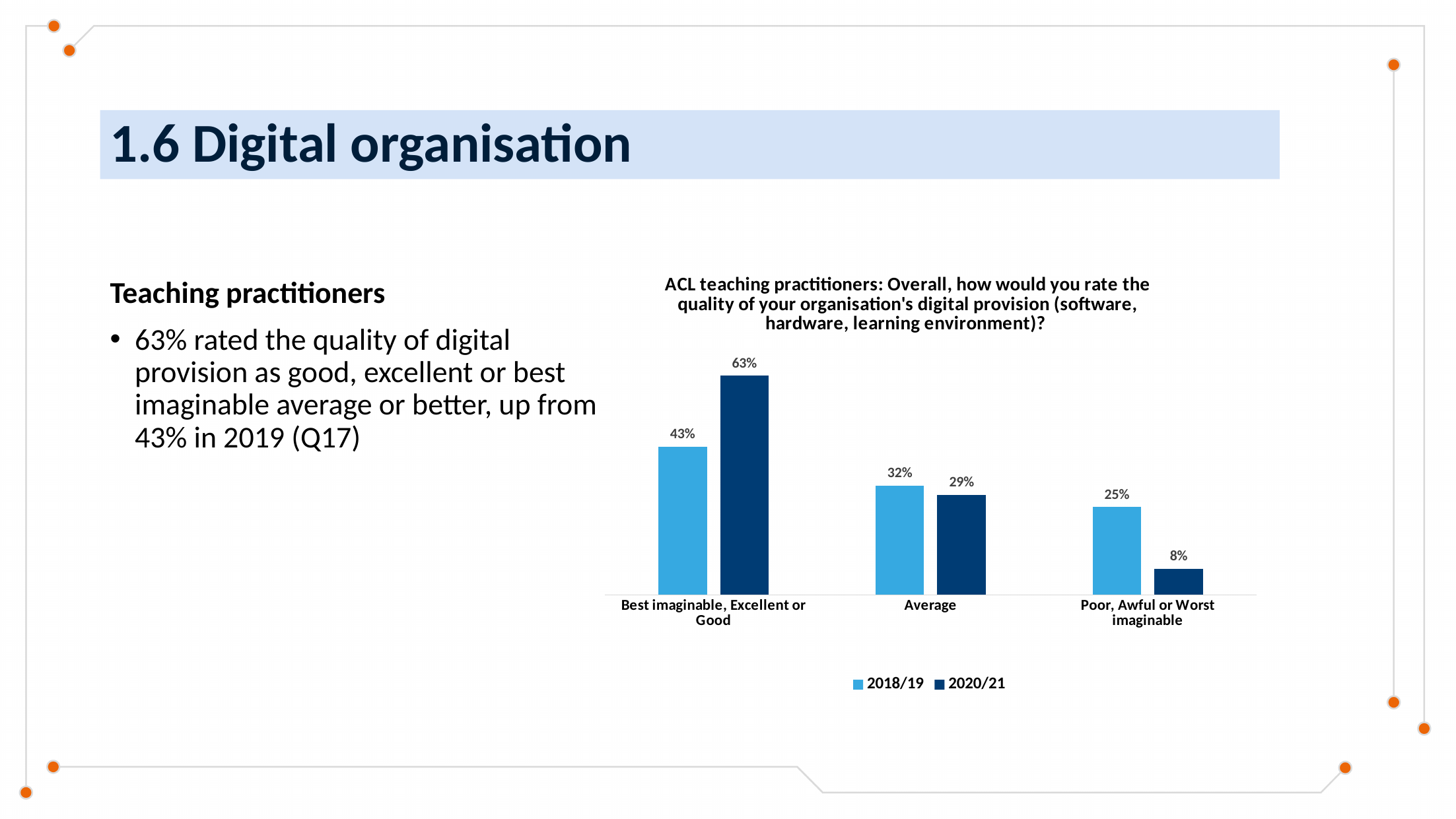
What percentage of ACL teaching practitioners rated digital provision as Best imaginable, Excellent or Good in 2018/19? 43% By how many percentage points did the Best imaginable, Excellent or Good rating change from 2018/19 to 2020/21? 20 percentage points What is the 2020/21 value for the Poor, Awful or Worst imaginable category? 8% Which category has the highest value for the 2020/21 series? Best imaginable, Excellent or Good What type of chart is shown on the slide? Bar chart What is the difference between the 2018/19 and 2020/21 values for Poor, Awful or Worst imaginable? 17 percentage points Which category has the lowest value for the 2018/19 series? Poor, Awful or Worst imaginable How many categories are shown on the x axis of the chart? 3 What is the 2018/19 value for the Average category? 32% For the Average category, which series has the larger value, 2018/19 or 2020/21? 2018/19 How many series does the chart legend list? 2 What percentage of ACL teaching practitioners rated digital provision as Best imaginable, Excellent or Good in 2020/21? 63%